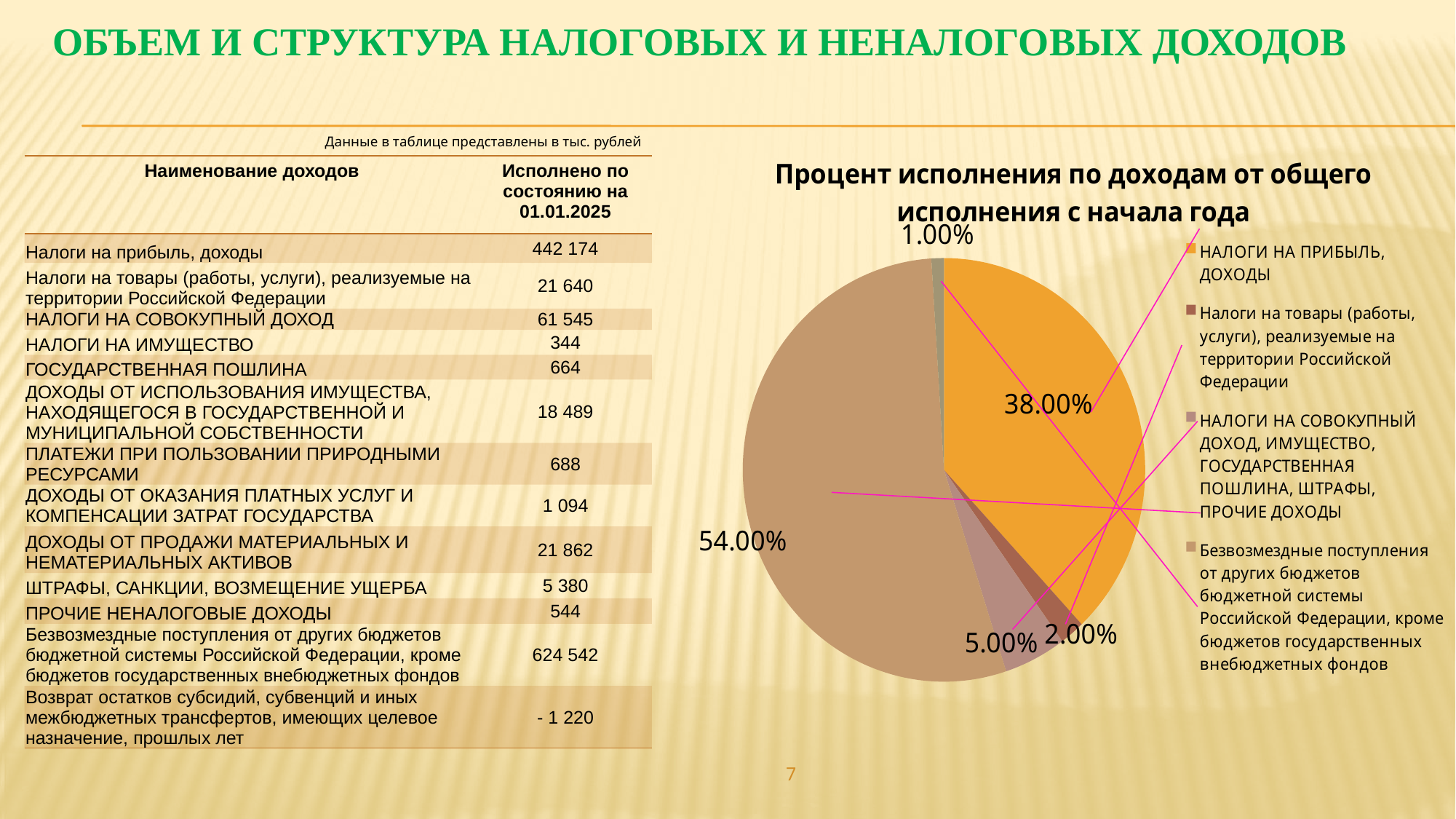
How many slices with data labels does the pie chart have? 5 What is the largest percentage shown on the pie chart? 54.00% Which legend entry corresponds to the largest slice of the pie chart? Безвозмездные поступления от других бюджетов бюджетной системы Российской Федерации, кроме бюджетов государственных внебюджетных фондов How many entries does the legend of the pie chart list? 4 What is the difference between the largest slice (54.00%) and the orange slice (38.00%) in the pie chart? 16.00% What share of the pie does the slice for НАЛОГИ НА ПРИБЫЛЬ, ДОХОДЫ (orange) represent? 38.00% Which slice is larger in the pie chart: the one labelled 5.00% or the one labelled 2.00%? 5.00% What share of the pie does the slice for Безвозмездные поступления от других бюджетов бюджетной системы Российской Федерации represent? 54.00% What kind of chart is shown on the slide? pie chart What colour is the slice labelled 38.00% in the pie chart? orange What is the smallest percentage shown on the pie chart? 1.00% What is the title of the pie chart? Процент исполнения по доходам от общего исполнения с начала года